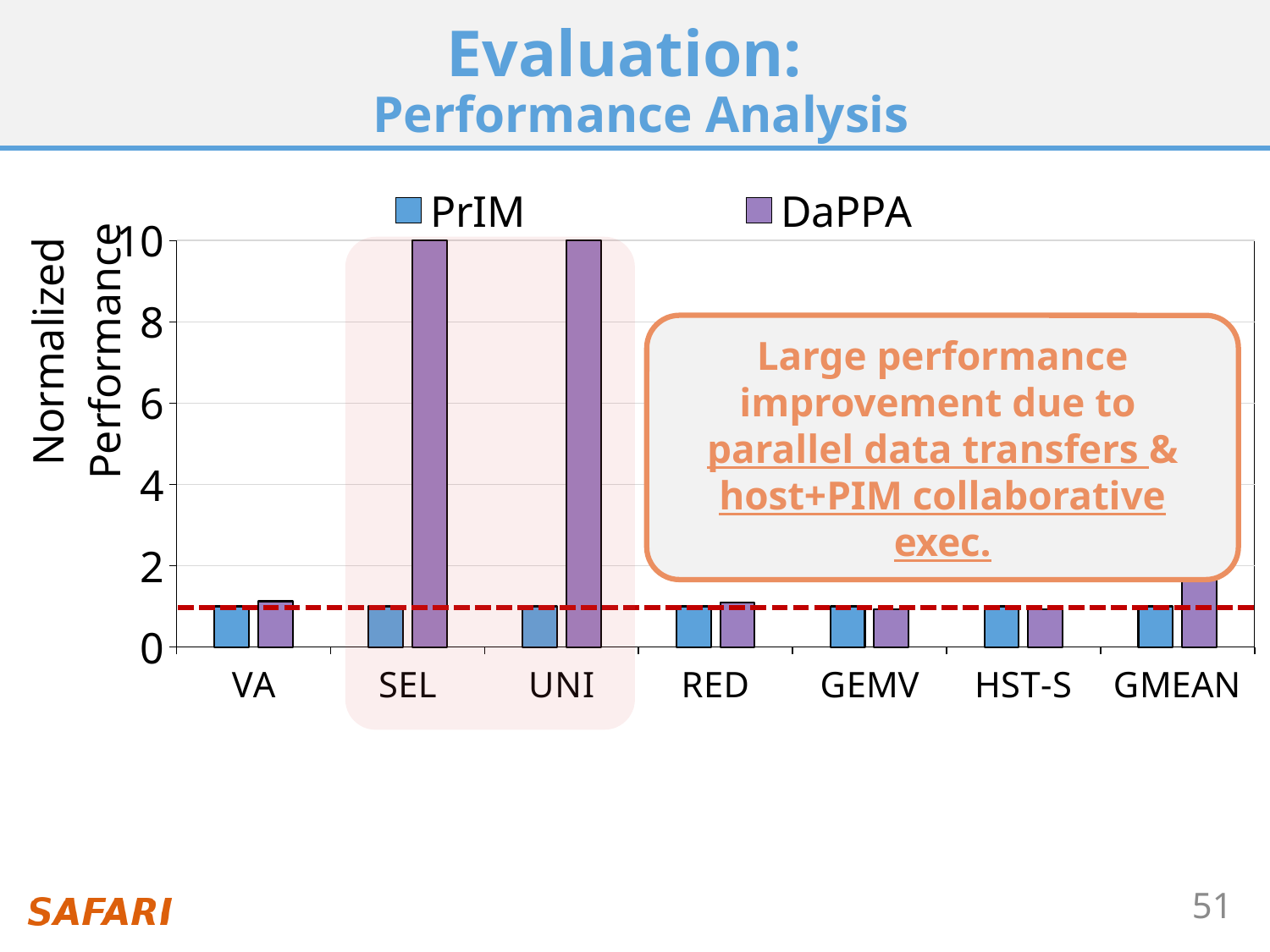
What is the label of the y axis? Normalized Performance Which series is shown in purple in the legend? DaPPA For GMEAN, which series has the larger value, PrIM or DaPPA? DaPPA How many series does the legend list? 2 Is the DaPPA value for SEL greater or less than 8? greater Is the DaPPA value for SEL greater or less than the DaPPA value for RED? greater Is the PrIM value for RED greater or less than 2? less What kind of chart is shown on the slide? bar chart Is the DaPPA value for UNI greater or less than 6? greater How many categories are shown on the x axis? 7